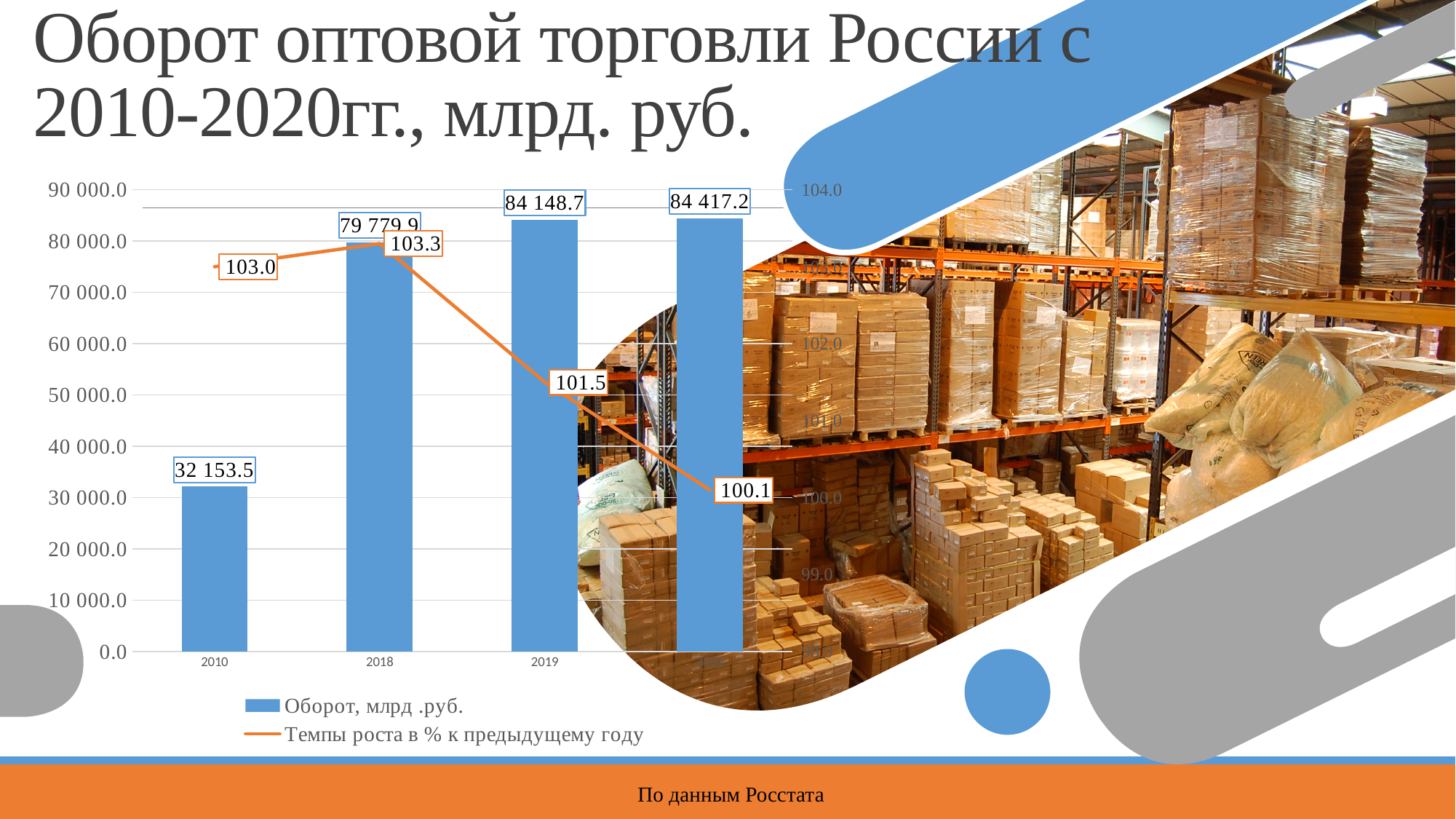
What is the growth rate (Темпы роста) value shown for 2019? 101.5 What is the difference between the growth rate values for 2018 and 2020 (the last point, 100.1)? 3.2 What is the difference between the turnover values for 2019 and 2018? 4 368.8 What is the turnover (Оборот) value for 2019? 84 148.7 How many series does the legend list? 2 Which year has the lowest turnover bar? 2010 Which is larger, the turnover for 2019 or for the last year (2020)? 2020 What is the turnover (Оборот) value for 2018? 79 779.9 What is the turnover (Оборот) value for 2010? 32 153.5 What is the growth rate (Темпы роста) value shown for 2018? 103.3 Does the growth rate line rise or fall from 2018 to the last year? fall Which year has the highest growth rate (Темпы роста) value? 2018